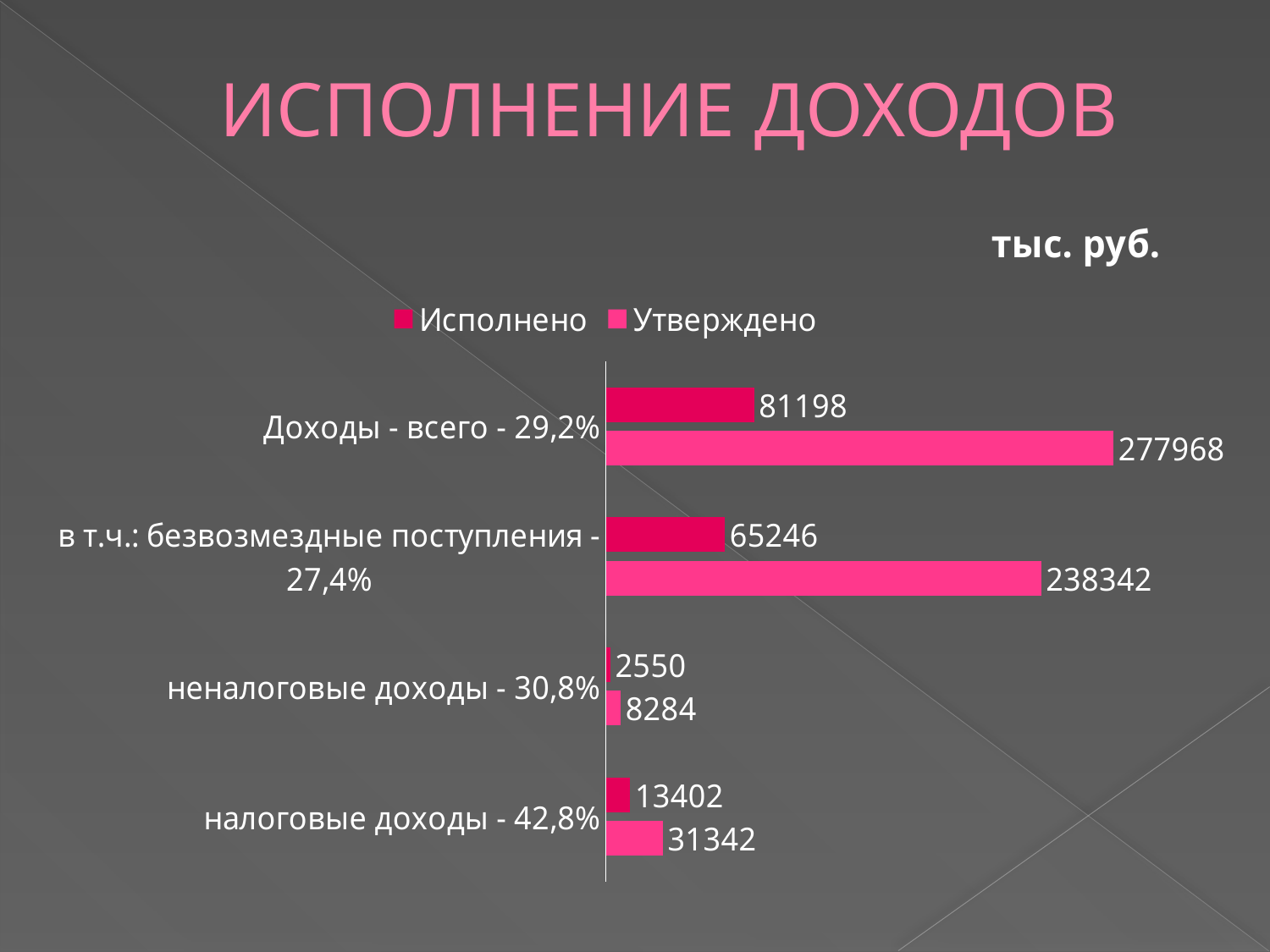
What is the Исполнено value for "налоговые доходы - 42,8%"? 13402 Which category has the highest Утверждено value? Доходы - всего - 29,2% What is the Утверждено value for "в т.ч.: безвозмездные поступления - 27,4%"? 238342 What is the difference between the Утверждено and Исполнено values for "налоговые доходы - 42,8%"? 17940 How many series does the legend list? 2 Which is larger: the Исполнено value for "в т.ч.: безвозмездные поступления - 27,4%" or the Утверждено value for "налоговые доходы - 42,8%"? Исполнено for в т.ч.: безвозмездные поступления - 27,4% Which category has the lowest Исполнено value? неналоговые доходы - 30,8% What is the Исполнено value for "неналоговые доходы - 30,8%"? 2550 What kind of chart is shown on the slide? Bar chart What is the difference between the Утверждено and Исполнено values for "Доходы - всего - 29,2%"? 196770 How many categories are shown on the chart? 4 What is the Утверждено value for "Доходы - всего - 29,2%"? 277968